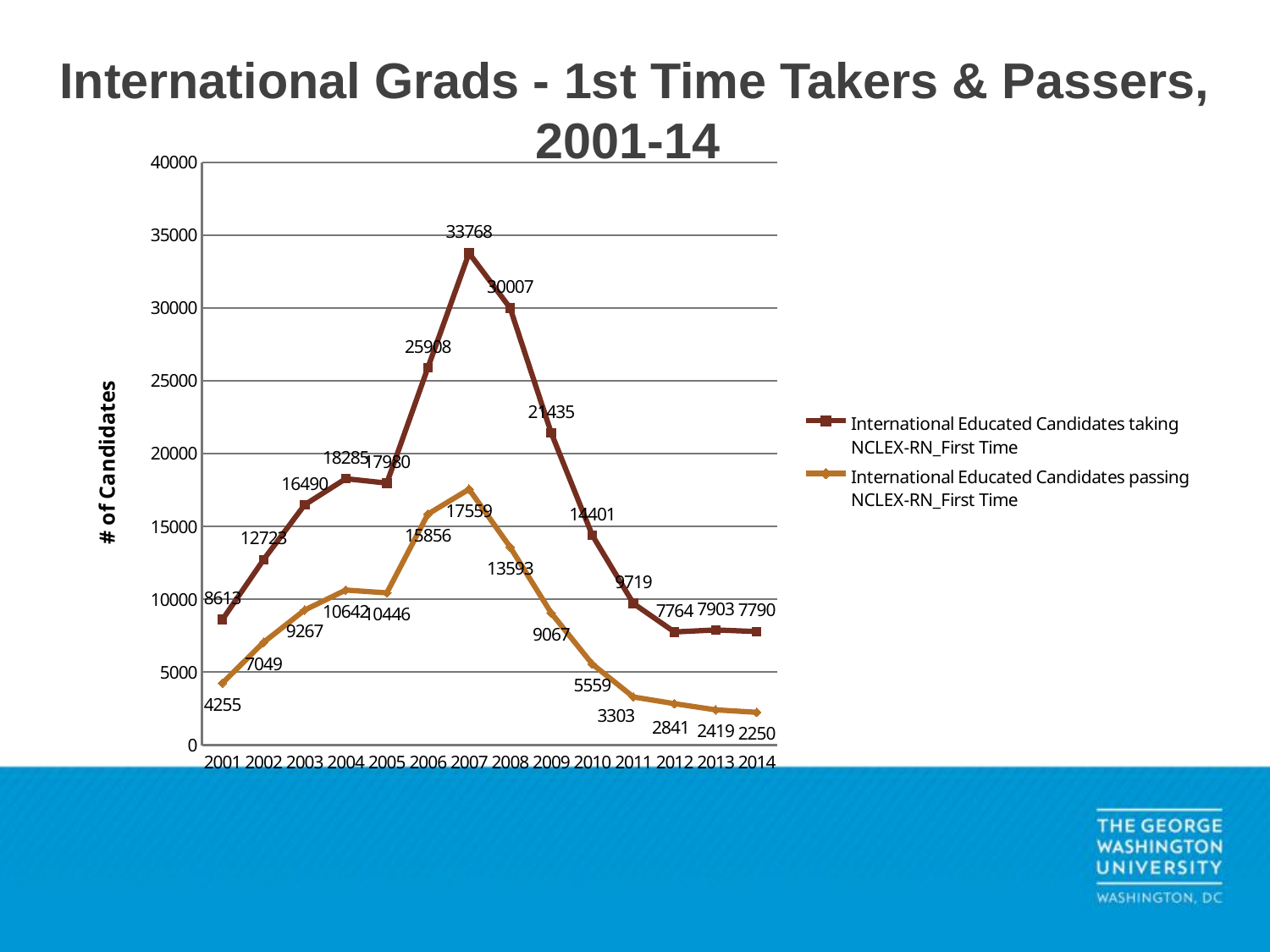
In which year was the number of International Educated Candidates passing the NCLEX-RN for the first time lowest? 2014 How many International Educated Candidates passed the NCLEX-RN on the first attempt in 2014? 2250 From 2008 to 2014, does the number of candidates passing the NCLEX-RN for the first time rise or fall? fall In which year was the number of International Educated Candidates taking the NCLEX-RN for the first time highest? 2007 Which year had more International Educated Candidates taking the NCLEX-RN for the first time, 2006 or 2009? 2006 How many years are shown on the x axis of the chart? 14 What is the title of the y axis? # of Candidates In 2007, what is the difference between the number of candidates taking and the number passing the NCLEX-RN for the first time? 16209 How many series does the legend list? 2 Is the number of candidates taking the NCLEX-RN for the first time in 2010 greater or less than 15000? less How many International Educated Candidates took the NCLEX-RN for the first time in 2007? 33768 What kind of chart is shown on the slide? line chart